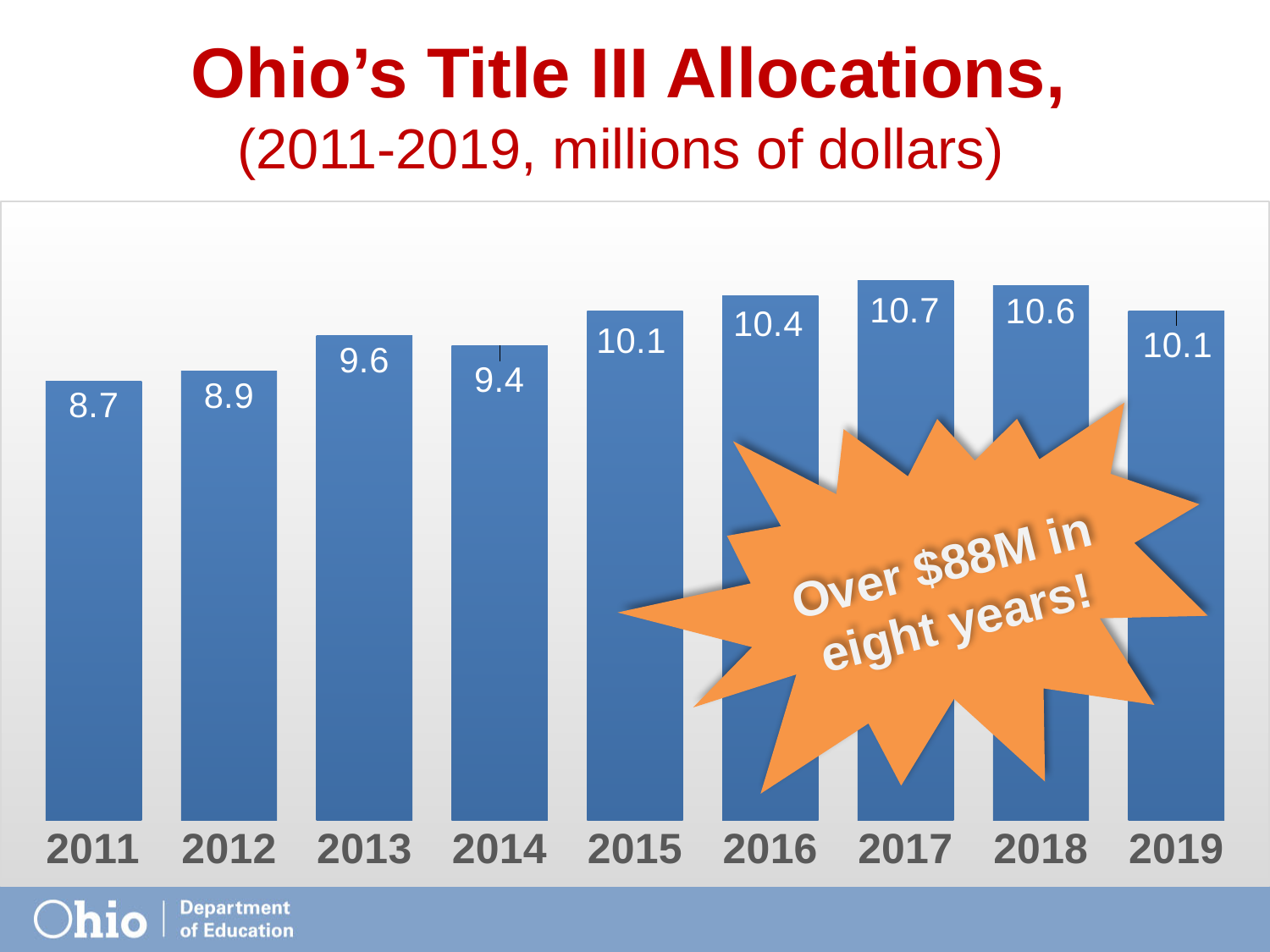
Did the allocation rise or fall from 2018 to 2019? Fall What does the orange starburst on the chart say? Over $88M in eight years! Which year had a larger allocation, 2013 or 2014? 2013 In what units are the allocations shown, according to the title? Millions of dollars How many years are shown on the chart? 9 What kind of chart is shown on the slide? Bar chart Which year had the highest Title III allocation? 2017 Which year had the lowest Title III allocation? 2011 What was Ohio's Title III allocation in 2017? 10.7 What is the difference between the 2017 and 2011 allocations? 2.0 What was Ohio's Title III allocation in 2014? 9.4 What was Ohio's Title III allocation in 2011? 8.7